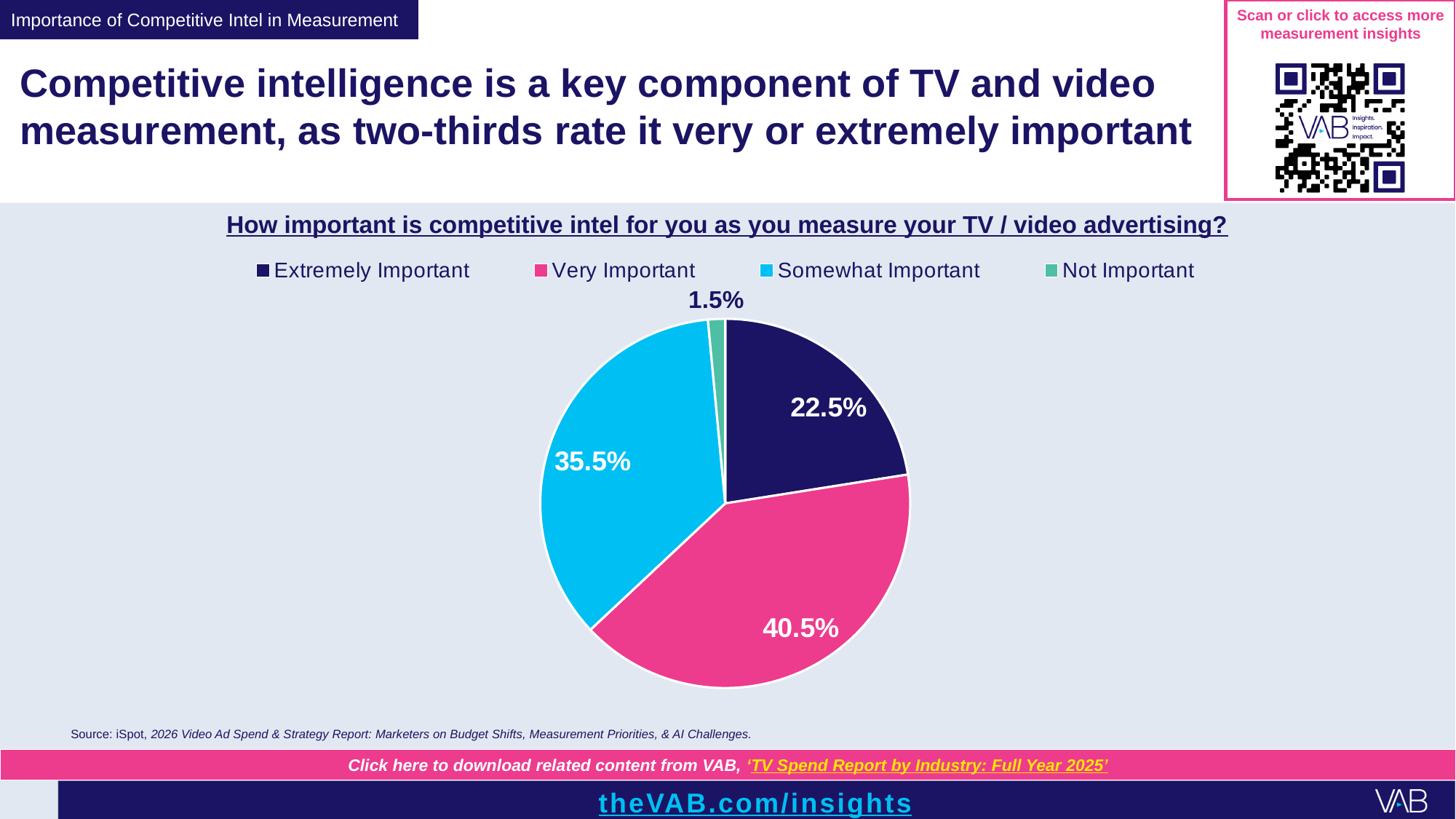
How many response categories are shown in the pie chart? 4 What percentage of respondents rated competitive intel as Very Important? 40.5% What is the combined share of Extremely Important and Very Important? 63% Which response category has the largest share of the pie? Very Important Which is larger, the share for Somewhat Important or the share for Extremely Important? Somewhat Important What percentage of respondents rated competitive intel as Somewhat Important? 35.5% What percentage of respondents rated competitive intel as Extremely Important? 22.5% What percentage of respondents rated competitive intel as Not Important? 1.5% What colour represents the Somewhat Important slice? Light blue Which response category has the smallest share of the pie? Not Important What type of chart is used on this slide? Pie chart What is the difference in percentage points between Very Important and Somewhat Important? 5 percentage points